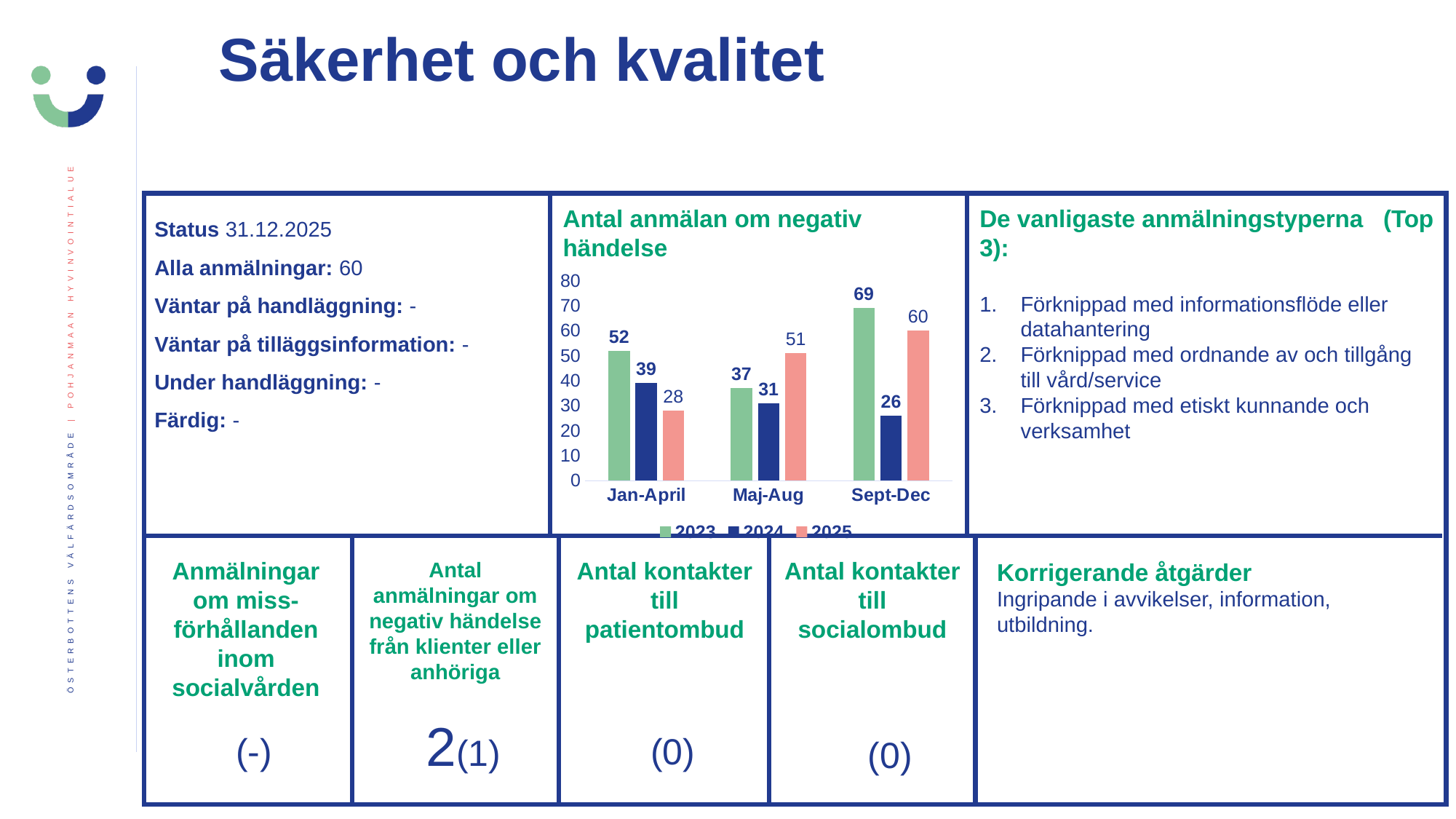
What is the value for 2023 in Jan-April? 52 Which period has the lowest value for 2025? Jan-April What kind of chart is shown? bar chart Which is larger in Maj-Aug, the value for 2023 or the value for 2025? 2025 Is the value for 2023 in Sept-Dec greater or less than 60? greater Which period has the highest value for 2023? Sept-Dec What is the title of the chart? Antal anmälan om negativ händelse How many series does the legend list? 3 How many periods are shown on the x axis? 3 What is the value for 2024 in Sept-Dec? 26 What is the difference between the 2023 and 2025 values in Sept-Dec? 9 What is the value for 2025 in Maj-Aug? 51